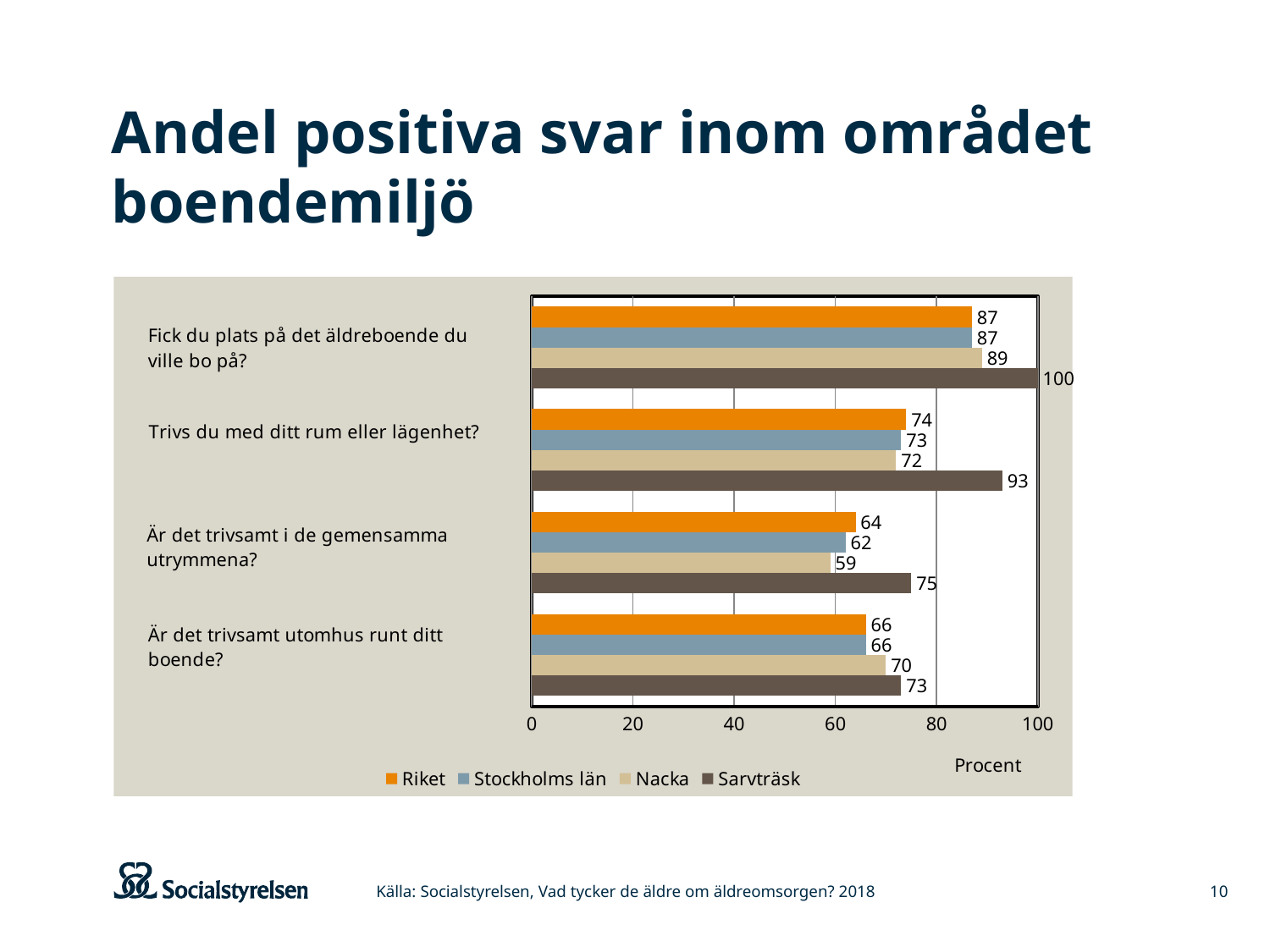
What value does Riket have for "Är det trivsamt i de gemensamma utrymmena?"? 64 How many series does the legend list? 4 How many question categories are shown on the chart? 4 What kind of chart is shown on the slide? Bar chart Which series has the highest value for "Trivs du med ditt rum eller lägenhet?"? Sarvträsk What value does Nacka have for "Trivs du med ditt rum eller lägenhet?"? 72 What value does Sarvträsk have for "Fick du plats på det äldreboende du ville bo på?"? 100 What is the difference between the Sarvträsk and Riket values for "Trivs du med ditt rum eller lägenhet?"? 19 What is the label on the horizontal axis of the chart? Procent What value does Stockholms län have for "Är det trivsamt utomhus runt ditt boende?"? 66 Which series has the lowest value for "Är det trivsamt i de gemensamma utrymmena?"? Nacka For "Är det trivsamt utomhus runt ditt boende?", which is larger: the Nacka value or the Riket value? Nacka